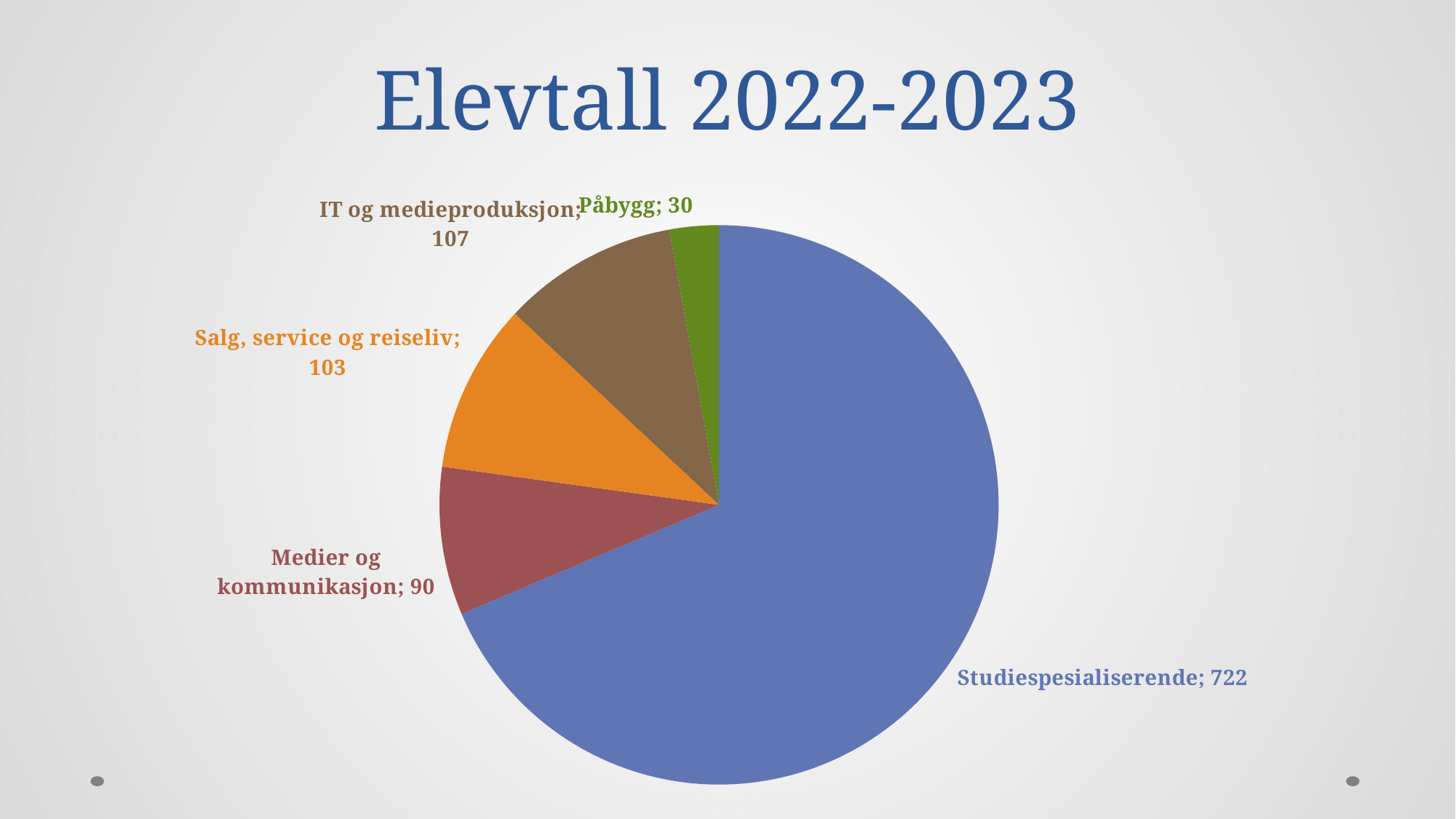
What is the difference between Studiespesialiserende and Medier og kommunikasjon? 632 What is the value for Studiespesialiserende? 722 What is the value for Påbygg? 30 How many slices does the pie chart have? 5 Which is larger, IT og medieproduksjon or Salg, service og reiseliv? IT og medieproduksjon What colour is the Studiespesialiserende slice? blue Which category has the largest slice? Studiespesialiserende What is the title of the chart? Elevtall 2022-2023 What kind of chart is shown on the slide? pie chart Which category has the smallest slice? Påbygg What is the total of all slices in the pie chart? 1052 What is the value for Salg, service og reiseliv? 103